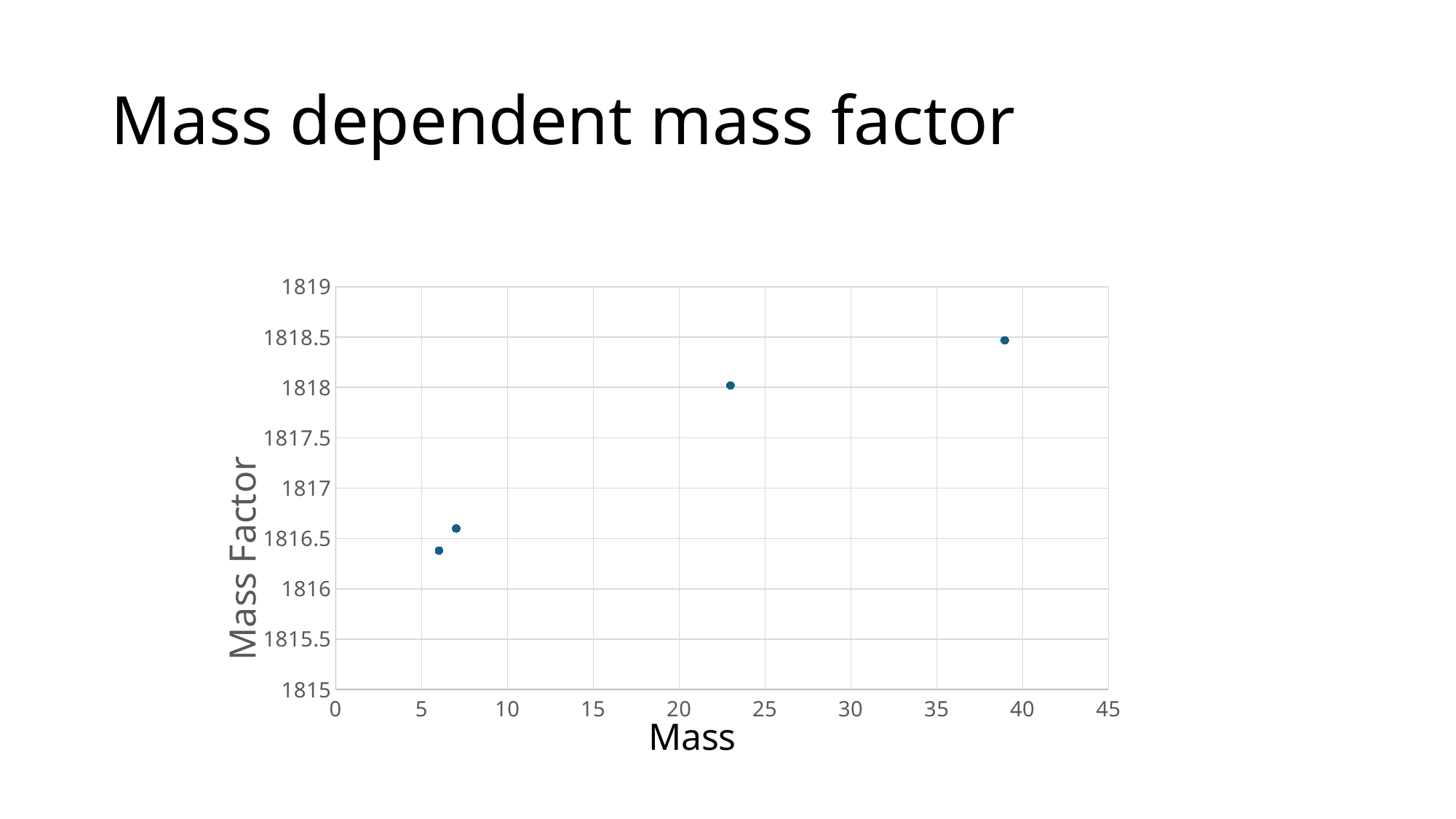
Which has the larger Mass Factor: the leftmost point or the rightmost point? the rightmost point Is the Mass Factor value for the point near Mass 23 greater or less than 1817.5? greater Is the Mass Factor value for the leftmost point (near Mass 5) greater or less than 1816? greater What is the title of the chart on the slide? Mass dependent mass factor Is the Mass Factor value for the leftmost point (near Mass 5) greater or less than 1817? less Which point has the highest Mass Factor: the one near Mass 23 or the one near Mass 40? the one near Mass 40 How many data points are plotted on the chart? 4 Do the Mass Factor values rise or fall as Mass increases along the x axis? rise What kind of chart is shown on the slide? scatter chart What is the label of the vertical axis? Mass Factor Which point has the lowest Mass Factor: the leftmost point or the point near Mass 23? the leftmost point